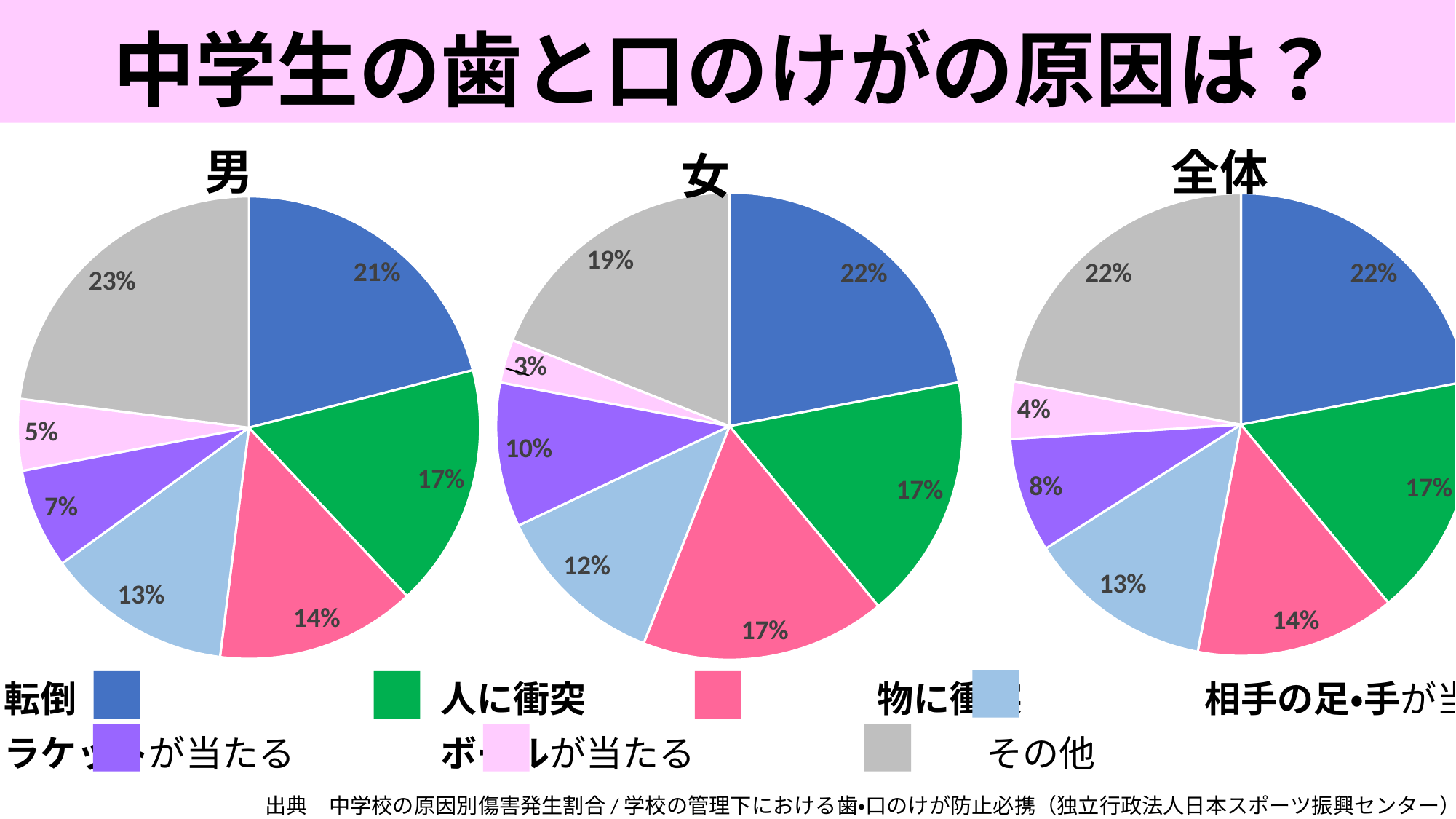
In the 女 pie chart, which is larger: the 転倒 share or the その他 share? 転倒 How many slices does the 男 pie chart have? 7 In the 男 pie chart, which category has the largest share? その他 In the 男 pie chart, what percentage is shown for 転倒 (the blue slice)? 21% How many pie charts are shown on the slide? 3 In the 男 pie chart, what is the share of the light blue slice (相手の足・手が当たる)? 13% What type of chart is used for 男, 女 and 全体? Pie chart In the 女 pie chart, which category has the smallest share? ボールが当たる In the 女 pie chart, what percentage is shown for その他 (the gray slice)? 19% In the 女 pie chart, what percentage is shown for the purple slice (ラケットが当たる)? 10% In the 全体 pie chart, what percentage is shown for 人に衝突 (the green slice)? 17% In the 全体 pie chart, what is the difference between the 転倒 share and the 人に衝突 share? 5%